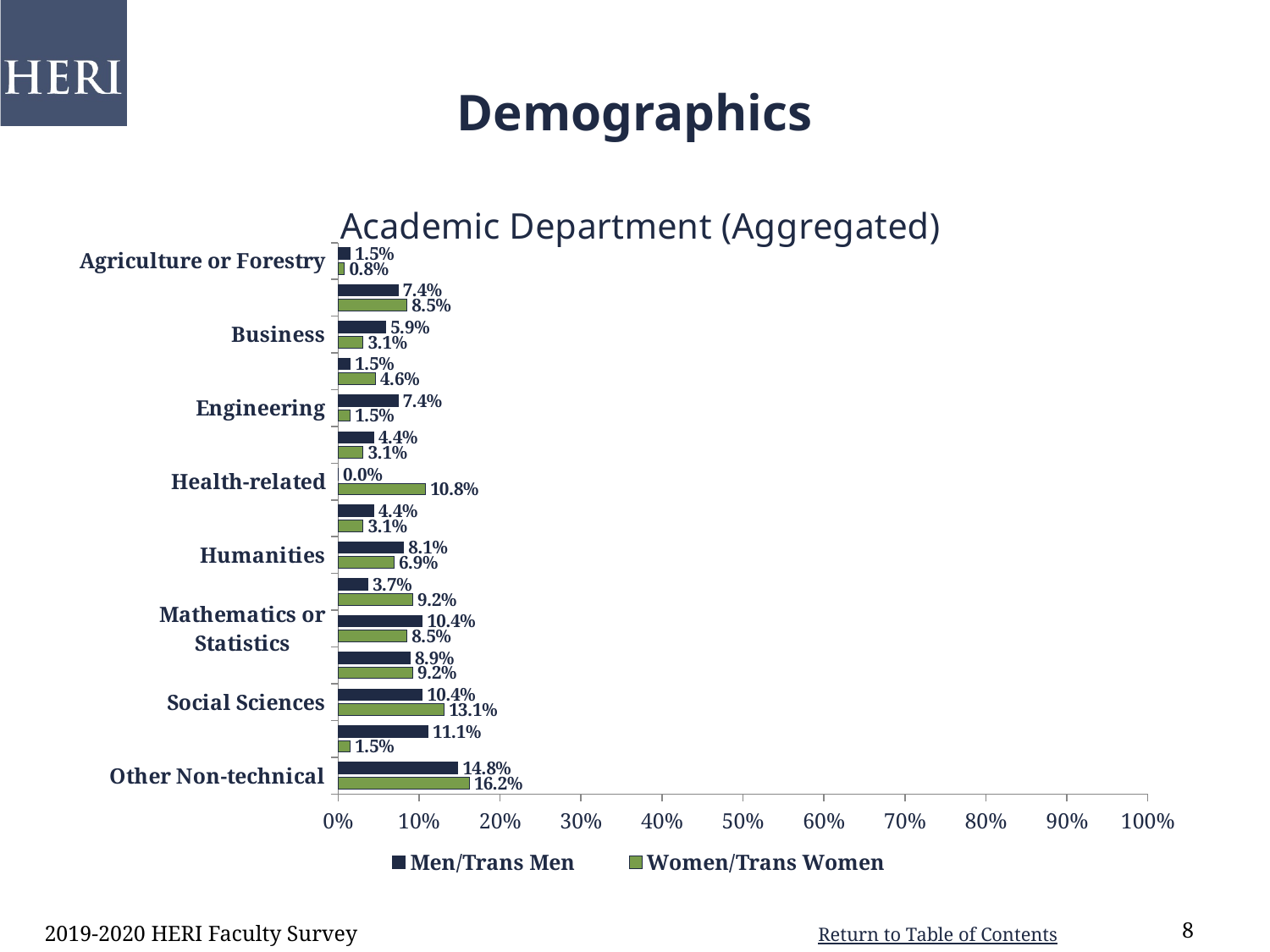
What is the Men/Trans Men value for Social Sciences? 10.4% What is the title of the chart? Academic Department (Aggregated) What is the Men/Trans Men value for Engineering? 7.4% What is the Women/Trans Women value for Other Non-technical? 16.2% How many series does the legend list? 2 What is the difference between the Men/Trans Men and Women/Trans Women values for Engineering? 5.9% Which labeled department has the highest Women/Trans Women value? Other Non-technical For Business, which is larger: the Men/Trans Men value or the Women/Trans Women value? Men/Trans Men What kind of chart is shown on the slide? Bar chart Which labeled department has the lowest Men/Trans Men value? Health-related What is the difference between the Women/Trans Women and Men/Trans Men values for Social Sciences? 2.7% What is the Women/Trans Women value for Health-related? 10.8%